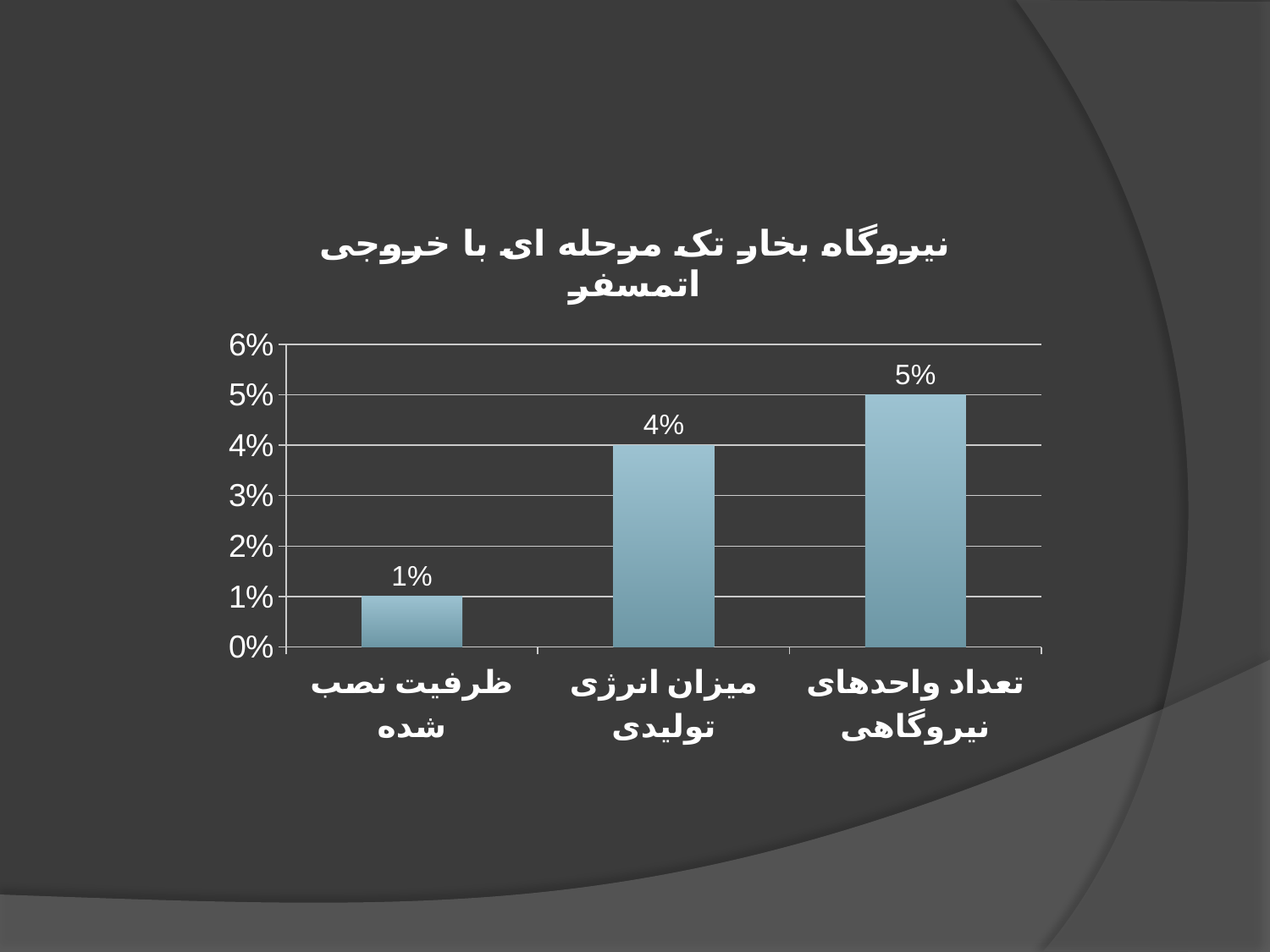
Which category has the lowest value? ظرفیت نصب شده How many categories are shown on the chart? 3 What is the difference between the values for تعداد واحدهای نیروگاهی and میزان انرژی تولیدی? 1% What is the value for تعداد واحدهای نیروگاهی? 5% What is the title of the chart? نیروگاه بخار تک مرحله ای با خروجی اتمسفر What kind of chart is shown on the slide? bar chart Which category has the highest value? تعداد واحدهای نیروگاهی Which is larger, the value for میزان انرژی تولیدی or the value for ظرفیت نصب شده? میزان انرژی تولیدی What is the value for ظرفیت نصب شده? 1% What is the difference between the values for تعداد واحدهای نیروگاهی and ظرفیت نصب شده? 4% Is the value for میزان انرژی تولیدی greater or less than 2%? greater What is the value for میزان انرژی تولیدی? 4%